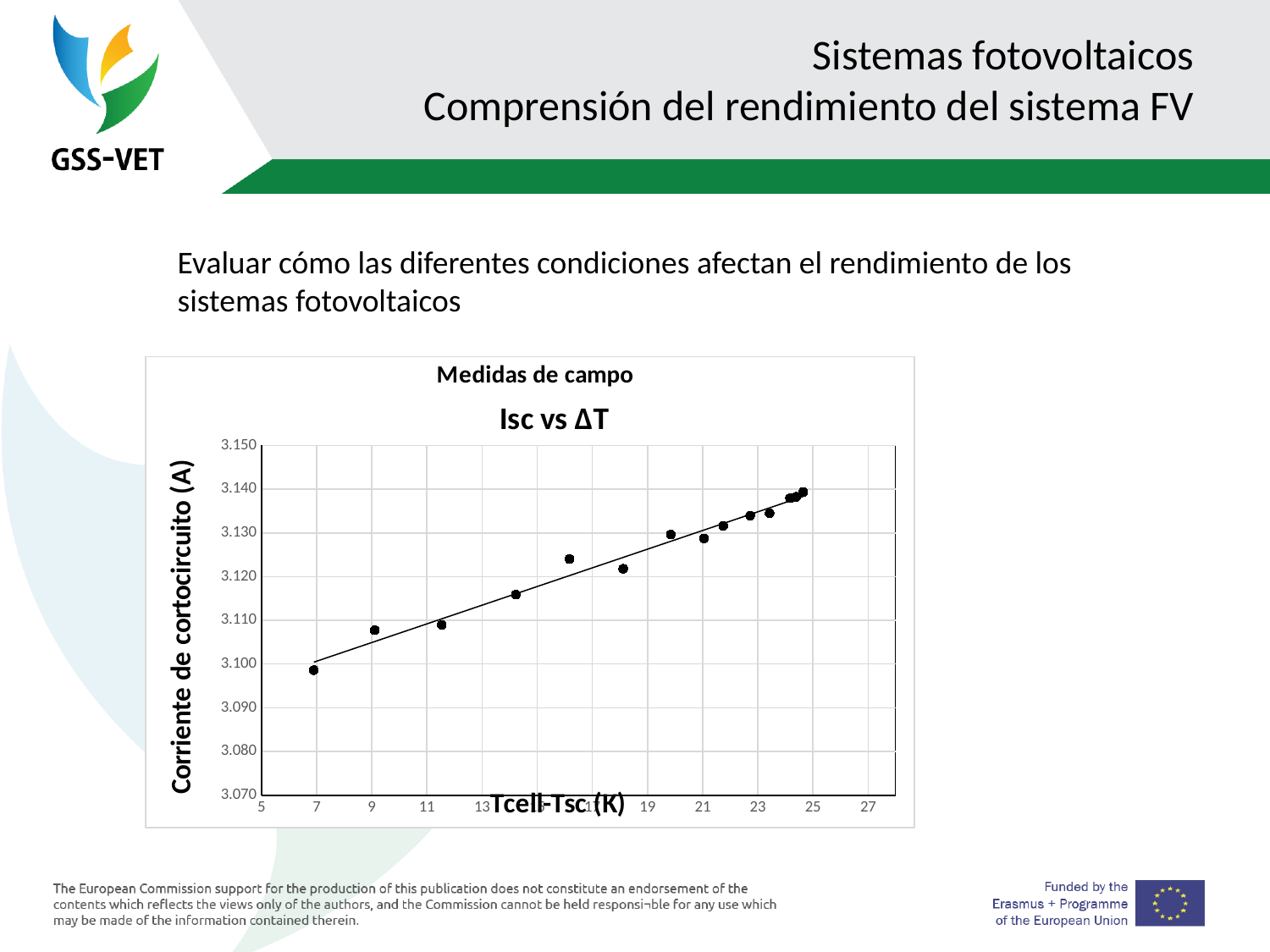
Which has the higher Isc value: the point near Tcell-Tsc = 7 K or the point near Tcell-Tsc = 24 K? The point near 24 K Is the Isc value of the point near Tcell-Tsc = 9 K greater or less than 3.120? less What is the label of the y axis of the chart? Corriente de cortocircuito (A) Do the plotted Isc values rise or fall as Tcell-Tsc increases along the x axis? Rise What is the highest value shown on the y axis of the chart? 3.150 Is the Isc value of the point near Tcell-Tsc = 14 K greater or less than 3.110? greater What is the title of the chart? Medidas de campo / Isc vs ΔT Is the Isc value of the rightmost points (near Tcell-Tsc = 24 K) greater or less than 3.130? greater What kind of chart is shown on the slide? Scatter chart